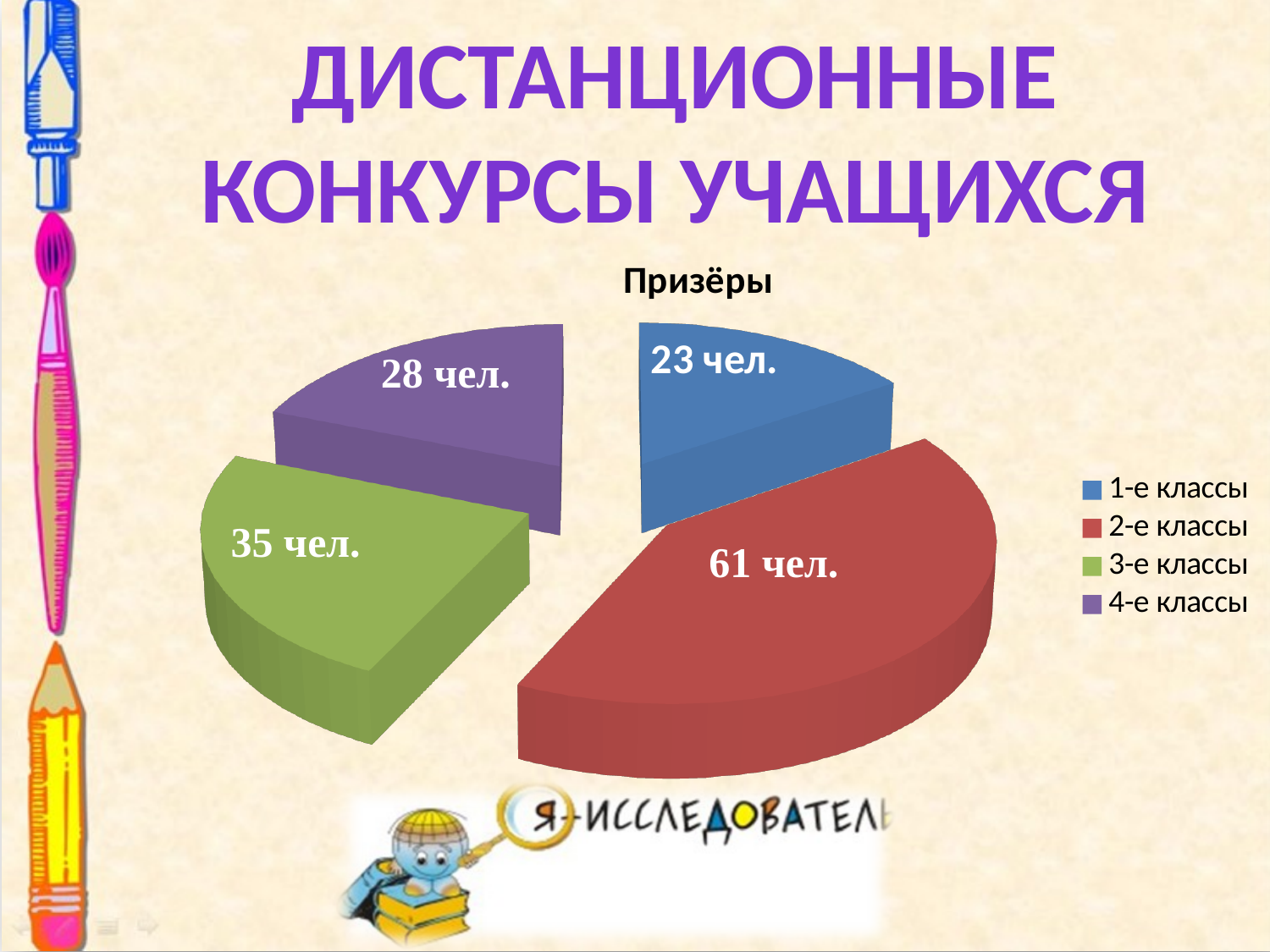
What is the value for 2-е классы? 61 чел. What is the value for 4-е классы? 28 чел. Which is larger, the value for 3-е классы or 4-е классы? 3-е классы What is the title of the pie chart? Призёры What is the value for 3-е классы? 35 чел. What type of chart is shown on the slide? pie chart Which category has the largest slice? 2-е классы What is the value for 1-е классы? 23 чел. What is the difference between the values for 2-е классы and 3-е классы? 26 чел. How many slices does the pie chart have? 4 How many entries does the legend list? 4 Which category has the smallest slice? 1-е классы